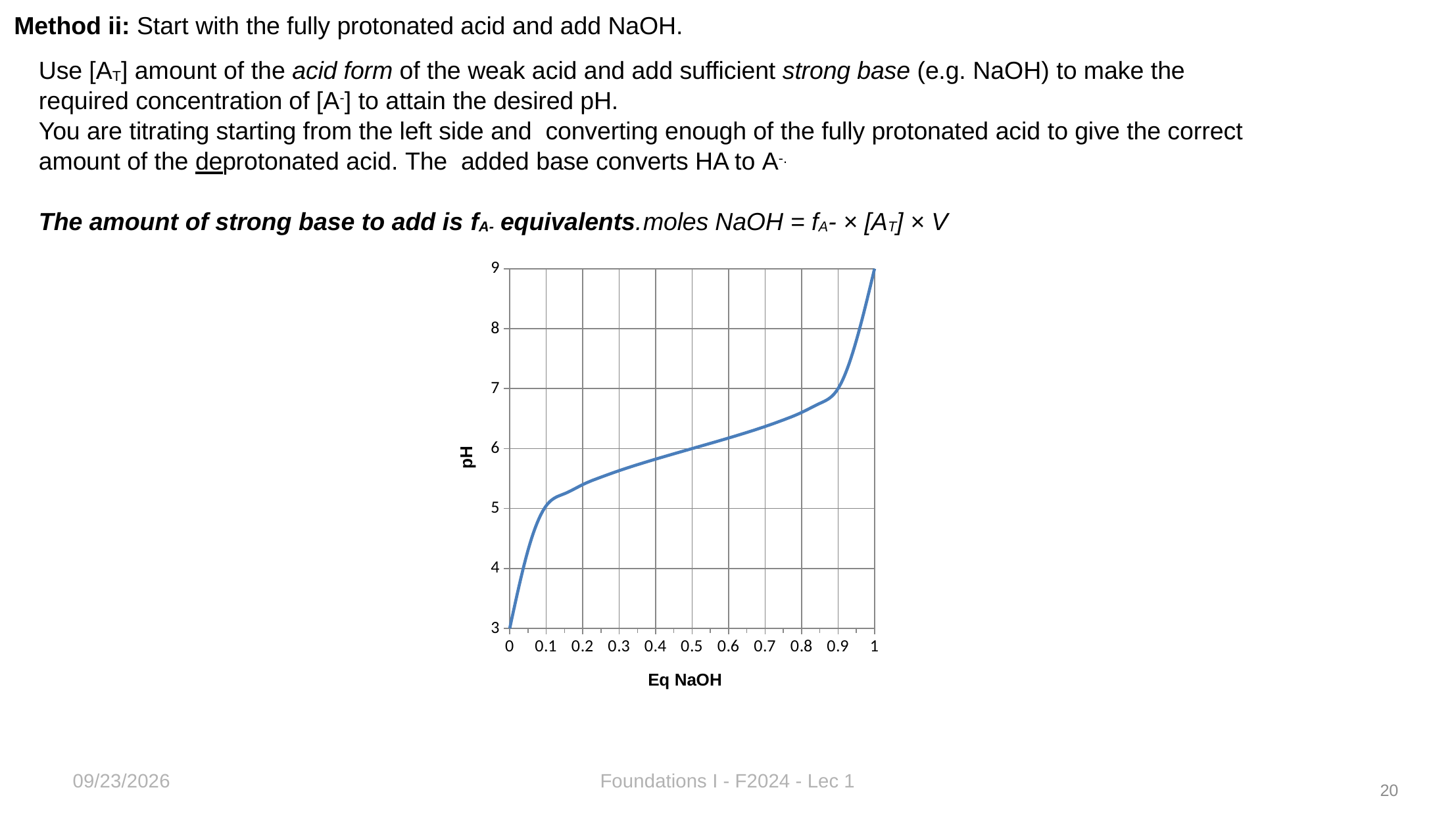
What kind of chart is shown on the slide? line chart What is the label of the y axis of the chart? pH At which Eq NaOH value is the pH highest? 1 What is the label of the x axis of the chart? Eq NaOH What is the pH at 1 Eq NaOH? 9 Is the pH at 0.2 Eq NaOH greater or less than 6? less Does the pH rise or fall as Eq NaOH increases from 0 to 1? rise What is the pH at 0 Eq NaOH? 3 Is the pH at 0.3 Eq NaOH greater or less than 5? greater Which is larger, the pH at 0.2 Eq NaOH or the pH at 0.8 Eq NaOH? 0.8 Eq NaOH At which Eq NaOH value is the pH lowest? 0 Is the pH at 0.8 Eq NaOH greater or less than 6? greater